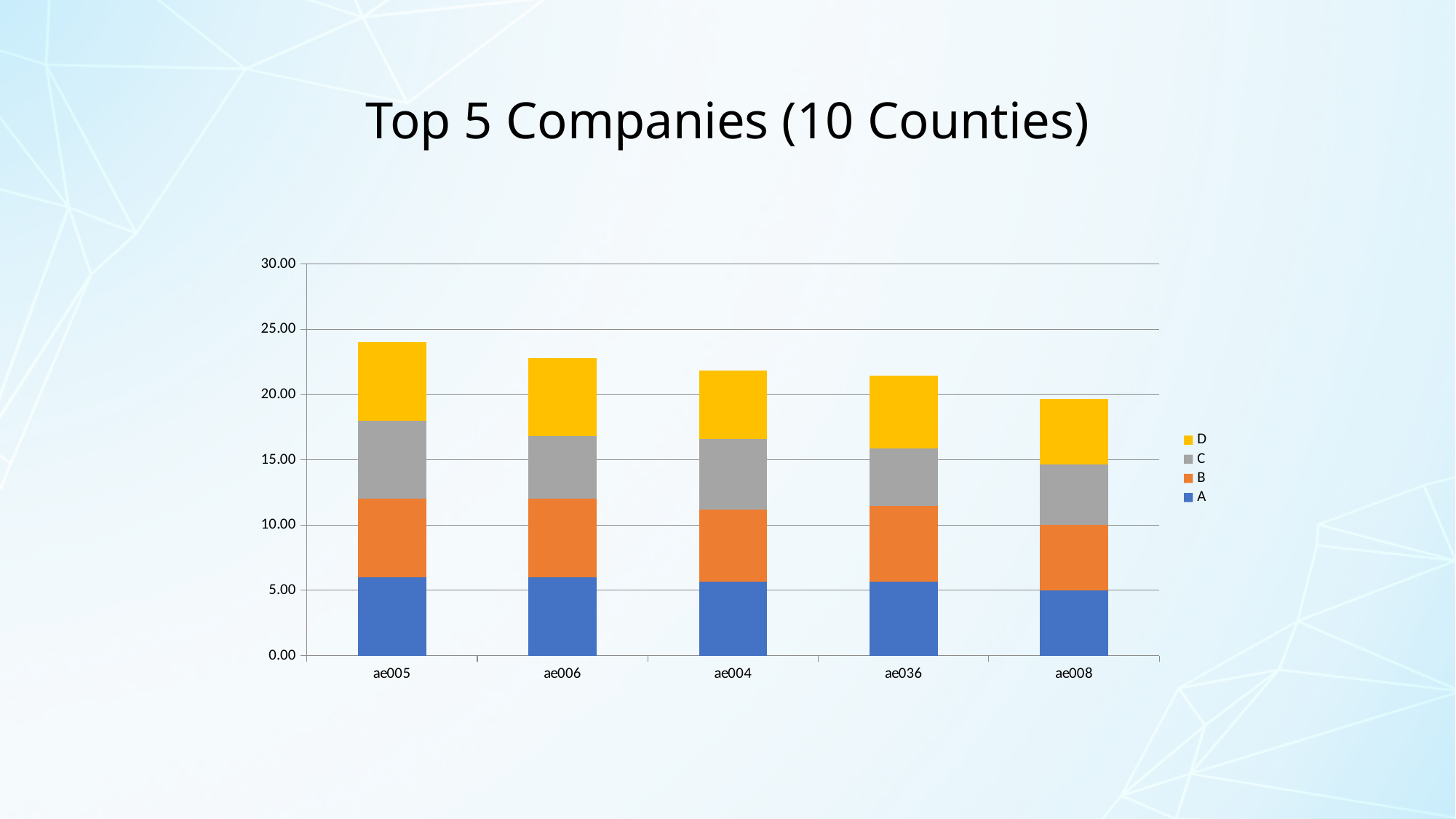
Which series is shown in yellow at the top of each stacked bar? D Which category has the shortest stacked bar? ae008 What kind of chart is shown on the slide? stacked bar chart How many series does the legend list? 4 What is the title of the chart? Top 5 Companies (10 Counties) Which has the larger stacked total, ae005 or ae008? ae005 Is the total stacked value for ae008 greater or less than 25.00? less Is the value of series A for ae005 greater or less than 5.00? greater Do the stacked bar totals rise or fall from left to right along the x axis? fall Which category has the tallest stacked bar? ae005 Is the total stacked value for ae005 greater or less than 20.00? greater How many categories are shown on the x axis? 5